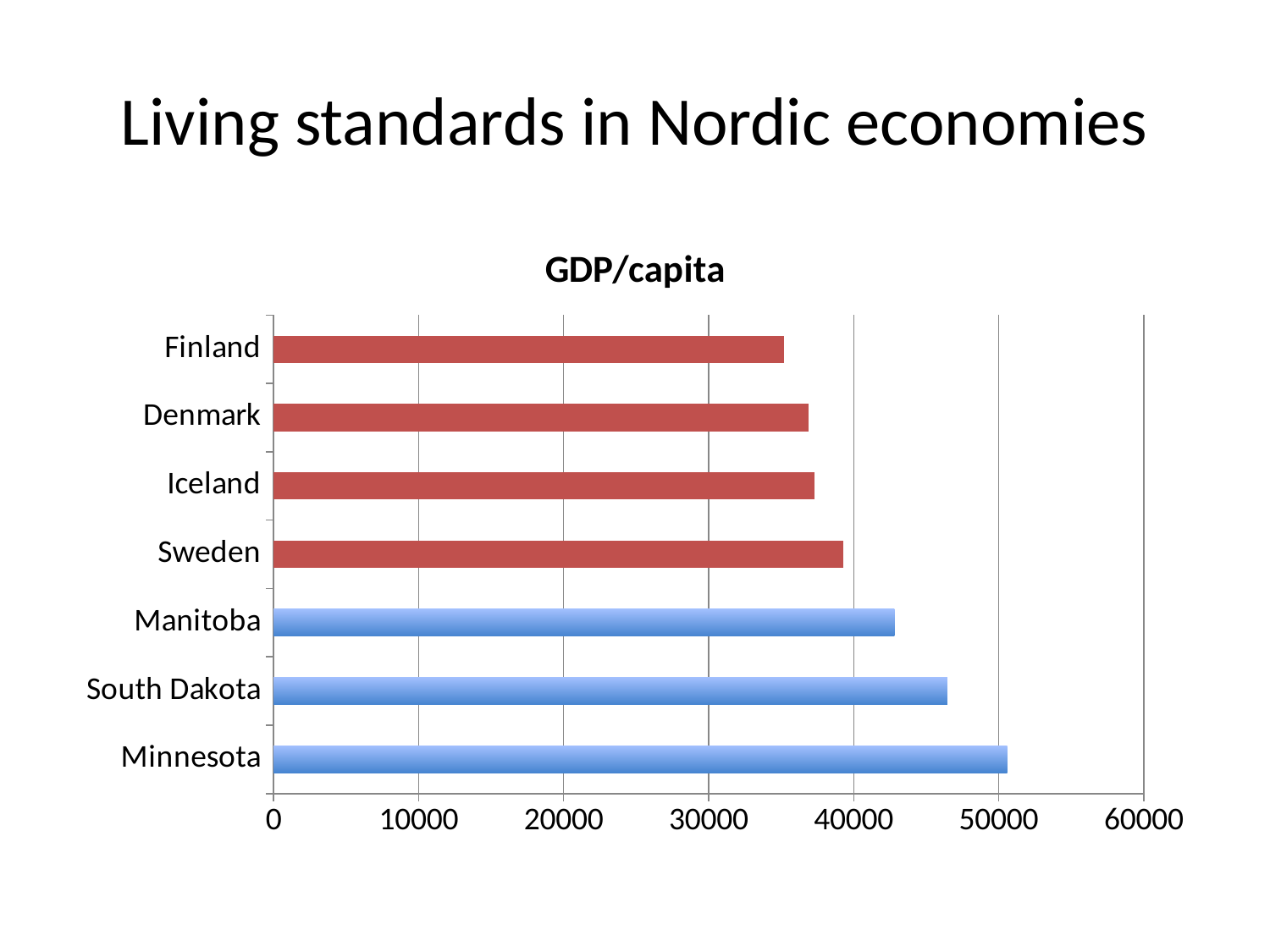
Is the value for Manitoba greater or less than 40000? greater What kind of chart is shown on the slide? bar chart How many categories are plotted in the chart? 7 Is the value for Finland greater or less than 40000? less Which has a higher GDP/capita, Manitoba or Sweden? Manitoba Is the value for Minnesota greater or less than 40000? greater Which category has the lowest GDP/capita? Finland What colour are the bars for Finland, Denmark, Iceland and Sweden? red Which category has the highest GDP/capita? Minnesota What is the title of the chart? GDP/capita